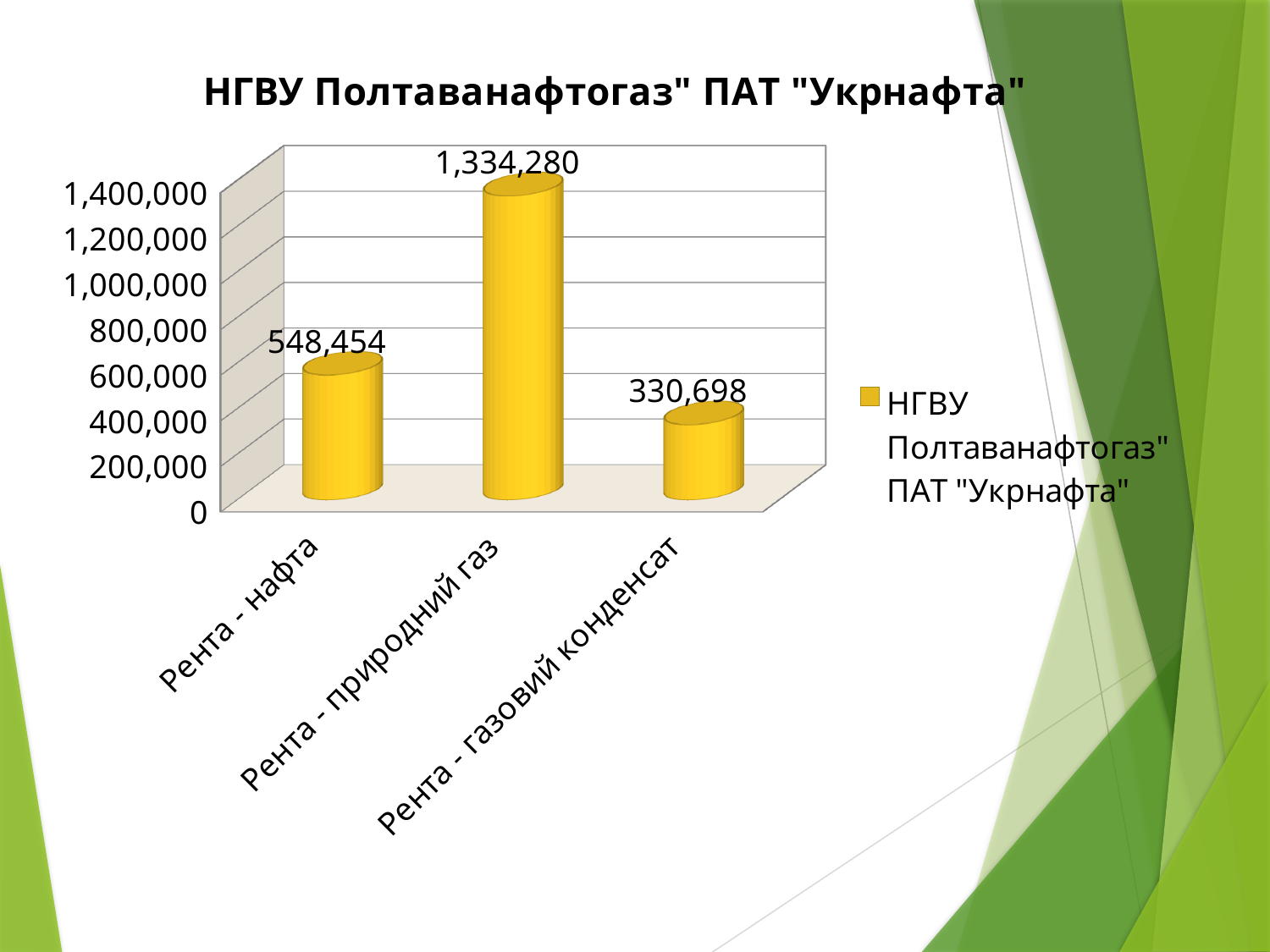
What is the difference between the values for "Рента - природний газ" and "Рента - нафта"? 785,826 Which category has the highest value? Рента - природний газ What kind of chart is shown on the slide? bar chart Is the value for "Рента - природний газ" greater or less than 1,200,000? greater What is the value for "Рента - газовий конденсат"? 330,698 What is the difference between the values for "Рента - нафта" and "Рента - газовий конденсат"? 217,756 Which is larger, the value for "Рента - нафта" or the value for "Рента - газовий конденсат"? Рента - нафта How many series does the legend list? 1 Which category has the lowest value? Рента - газовий конденсат What is the value for "Рента - нафта"? 548,454 How many categories are shown on the x axis? 3 What is the value for "Рента - природний газ"? 1,334,280